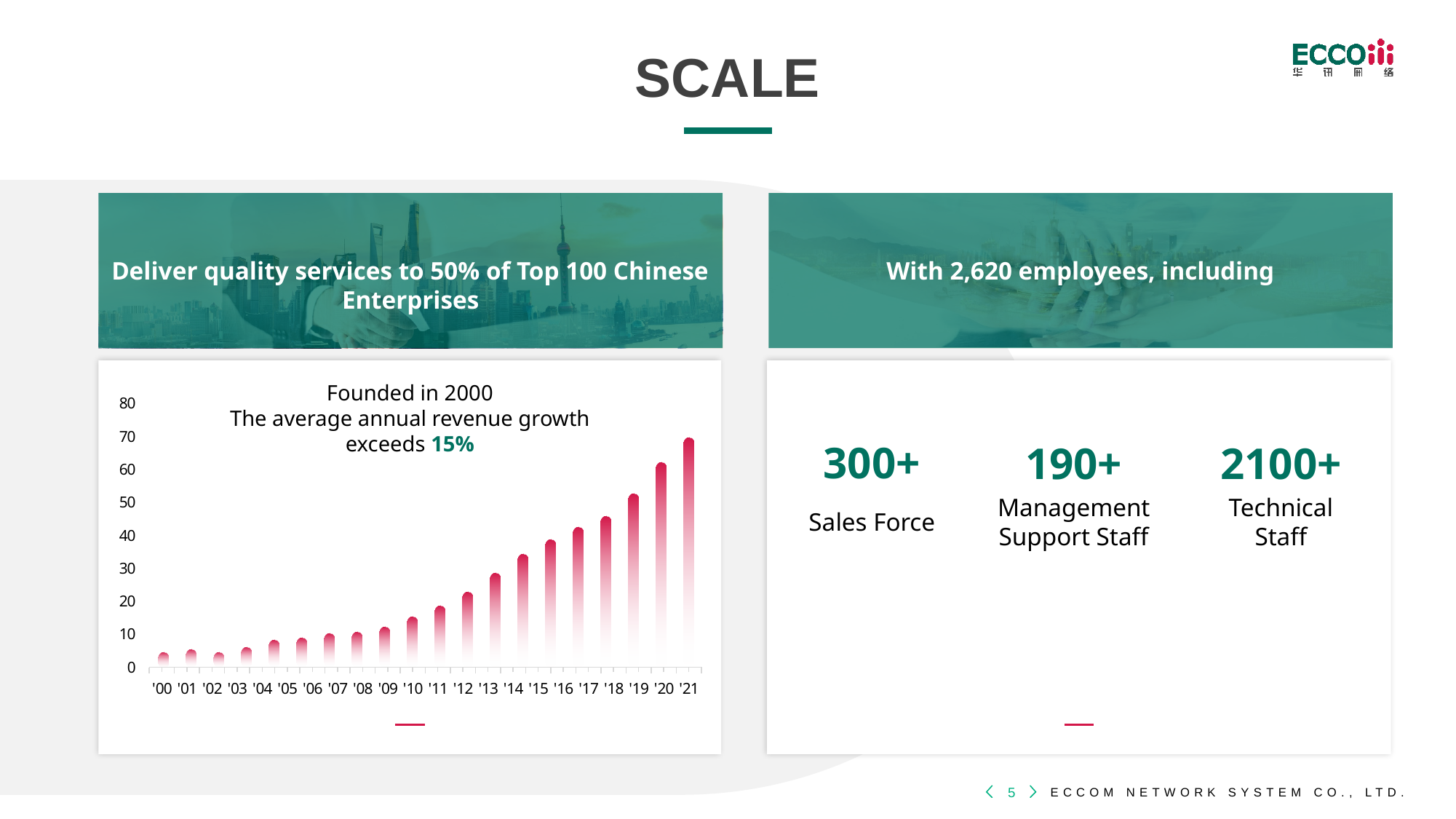
What is the highest value shown on the y axis of the revenue chart? 80 Which is larger, the value for '18 or the value for '10? '18 Is the value for '05 greater or less than 20? less Is the value for '15 greater or less than 20? greater Do the bar values generally rise or fall from '00 to '21? rise How many years (bars) are plotted on the revenue chart? 22 Is the value for '00 greater or less than 10? less Which year has the highest bar on the revenue chart? '21 According to the text above the chart, what does the average annual revenue growth exceed? 15% What kind of chart is shown on the left panel of the slide? bar chart